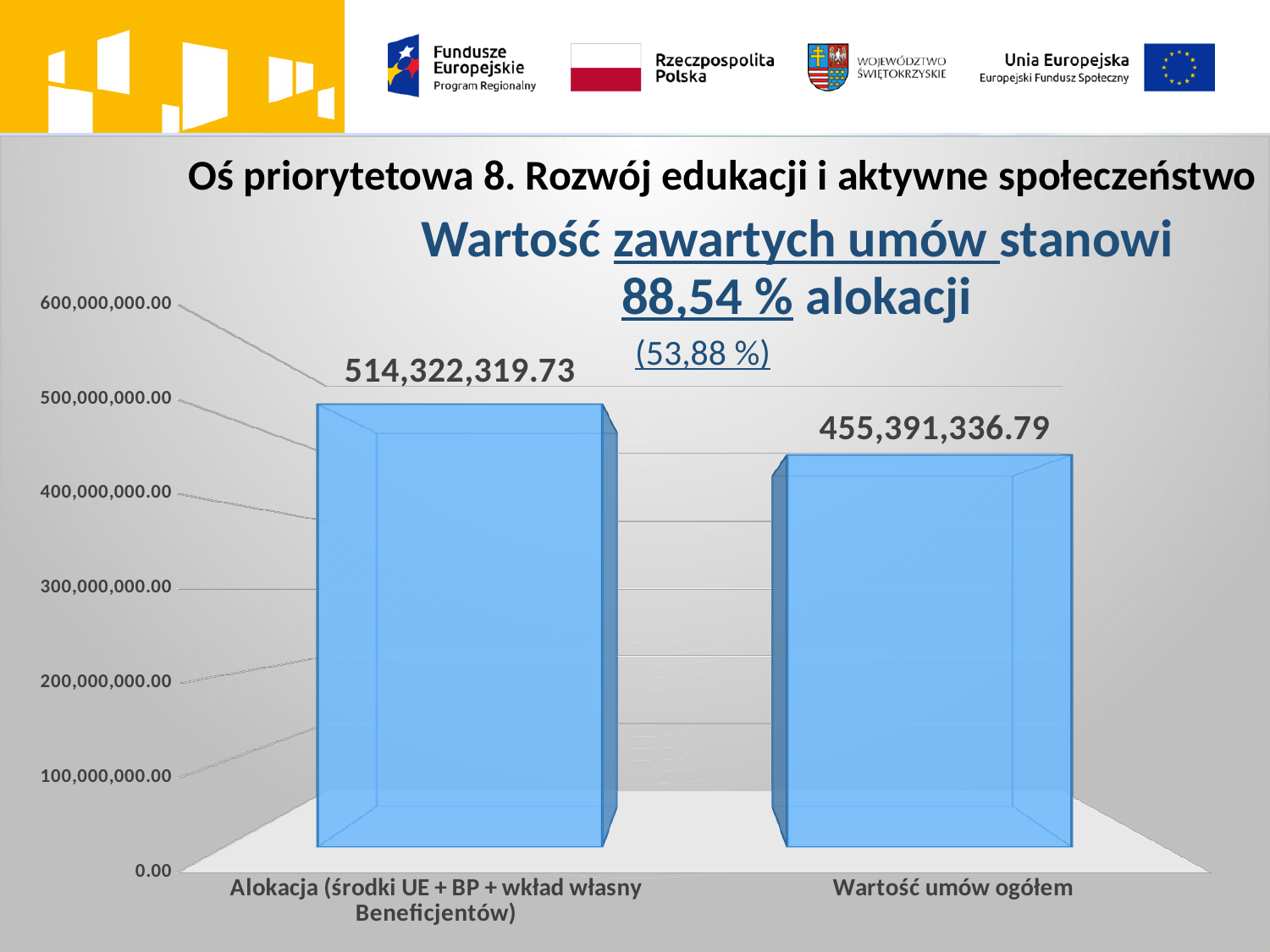
Which is larger: the value for "Alokacja (środki UE + BP + wkład własny Beneficjentów)" or the value for "Wartość umów ogółem"? Alokacja (środki UE + BP + wkład własny Beneficjentów) Is the value for "Alokacja (środki UE + BP + wkład własny Beneficjentów)" greater or less than 500,000,000.00? greater Which category has the highest value? Alokacja (środki UE + BP + wkład własny Beneficjentów) Which category has the lowest value? Wartość umów ogółem What is the difference between the value for "Alokacja (środki UE + BP + wkład własny Beneficjentów)" and the value for "Wartość umów ogółem"? 58,930,982.94 According to the text on the slide, what percentage of the allocation does the value of concluded contracts represent? 88,54 % What is the value of the bar labelled "Wartość umów ogółem"? 455,391,336.79 What kind of chart is shown on the slide? bar chart How many bars are shown in the chart? 2 What is the value of the bar labelled "Alokacja (środki UE + BP + wkład własny Beneficjentów)"? 514,322,319.73 What is the highest value shown on the vertical axis of the chart? 600,000,000.00 Is the value for "Wartość umów ogółem" greater or less than 500,000,000.00? less